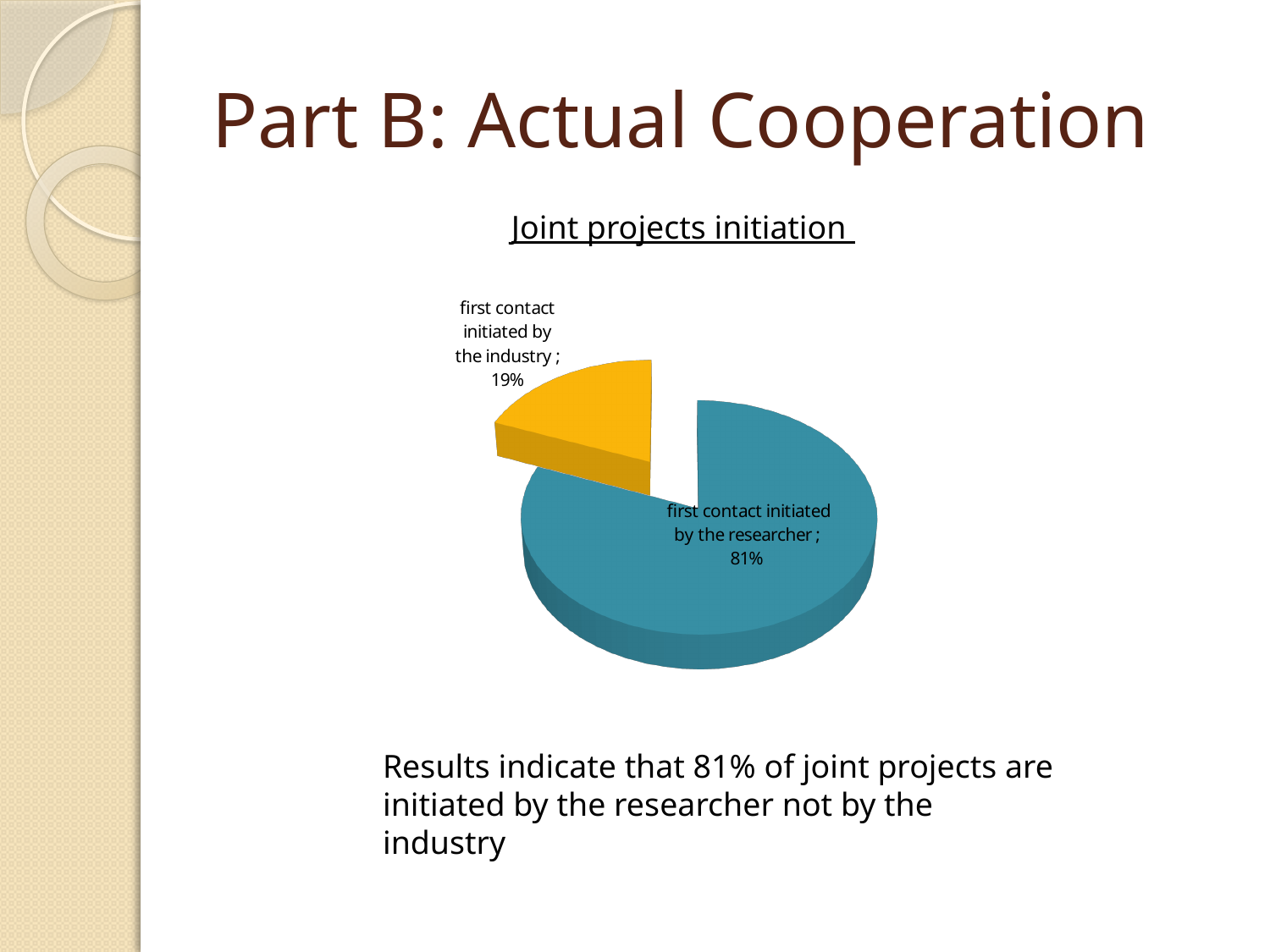
What share of joint projects had the first contact initiated by the researcher? 81% What share of joint projects had the first contact initiated by the industry? 19% How many slices does the pie chart have? 2 Which slice of the pie is the smallest? first contact initiated by the industry What kind of chart is shown on the slide? pie chart What colour is the slice for first contact initiated by the industry? yellow Which is larger: the share initiated by the researcher or the share initiated by the industry? first contact initiated by the researcher Which slice of the pie is the largest? first contact initiated by the researcher What is the title of the chart? Joint projects initiation What is the difference in percentage points between the researcher-initiated and industry-initiated slices? 62 What is the total of the two slice percentages shown on the pie chart? 100%